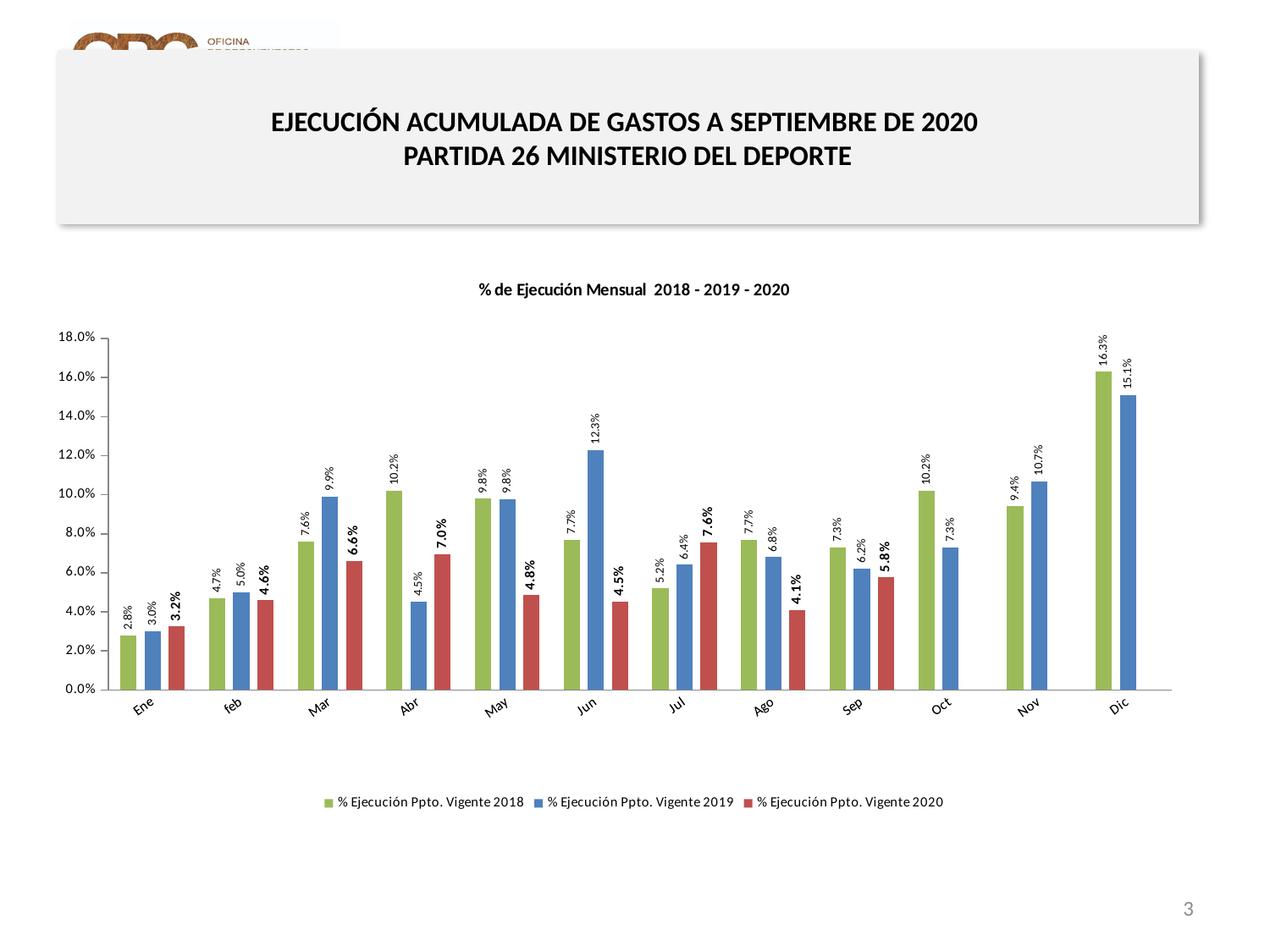
Which month has the highest value for % Ejecución Ppto. Vigente 2020? Jul What is the value of % Ejecución Ppto. Vigente 2020 for Abr? 7.0% How many series does the legend list? 3 How many months are shown on the x axis? 12 What is the value of % Ejecución Ppto. Vigente 2018 for Dic? 16.3% Which is larger for Abr: the 2018 value or the 2019 value? 2018 What is the difference between the 2019 and 2018 values for Jun? 4.6% What kind of chart is shown on the slide? Bar chart What is the title of the chart? % de Ejecución Mensual 2018 - 2019 - 2020 Which month has the lowest value for % Ejecución Ppto. Vigente 2018? Ene Is the value for % Ejecución Ppto. Vigente 2019 in Dic greater or less than 14.0%? greater What is the value of % Ejecución Ppto. Vigente 2019 for Jun? 12.3%